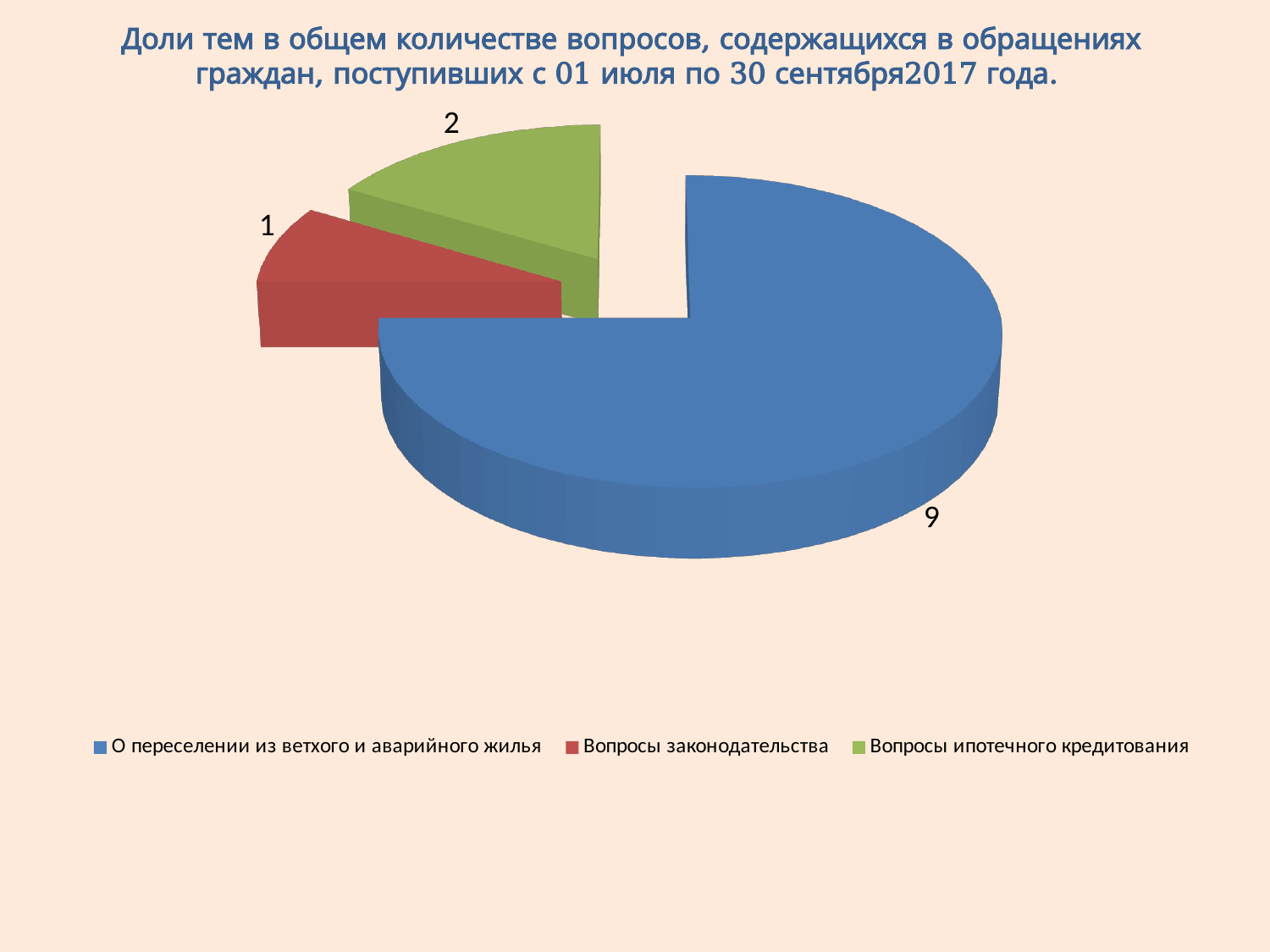
What type of chart is shown on the slide? Pie chart Which category has the largest slice of the pie? О переселении из ветхого и аварийного жилья What share of the pie does "О переселении из ветхого и аварийного жилья" represent? 75% What is the value for "О переселении из ветхого и аварийного жилья"? 9 What is the value for "Вопросы ипотечного кредитования"? 2 Which is larger: the value for "Вопросы ипотечного кредитования" or the value for "Вопросы законодательства"? Вопросы ипотечного кредитования Which category has the smallest slice of the pie? Вопросы законодательства How many slices does the pie chart have? 3 What is the difference between the values for "О переселении из ветхого и аварийного жилья" and "Вопросы ипотечного кредитования"? 7 What is the total of all the values shown on the pie chart? 12 Which colour represents "Вопросы ипотечного кредитования" in the legend? Green What is the value for "Вопросы законодательства"? 1